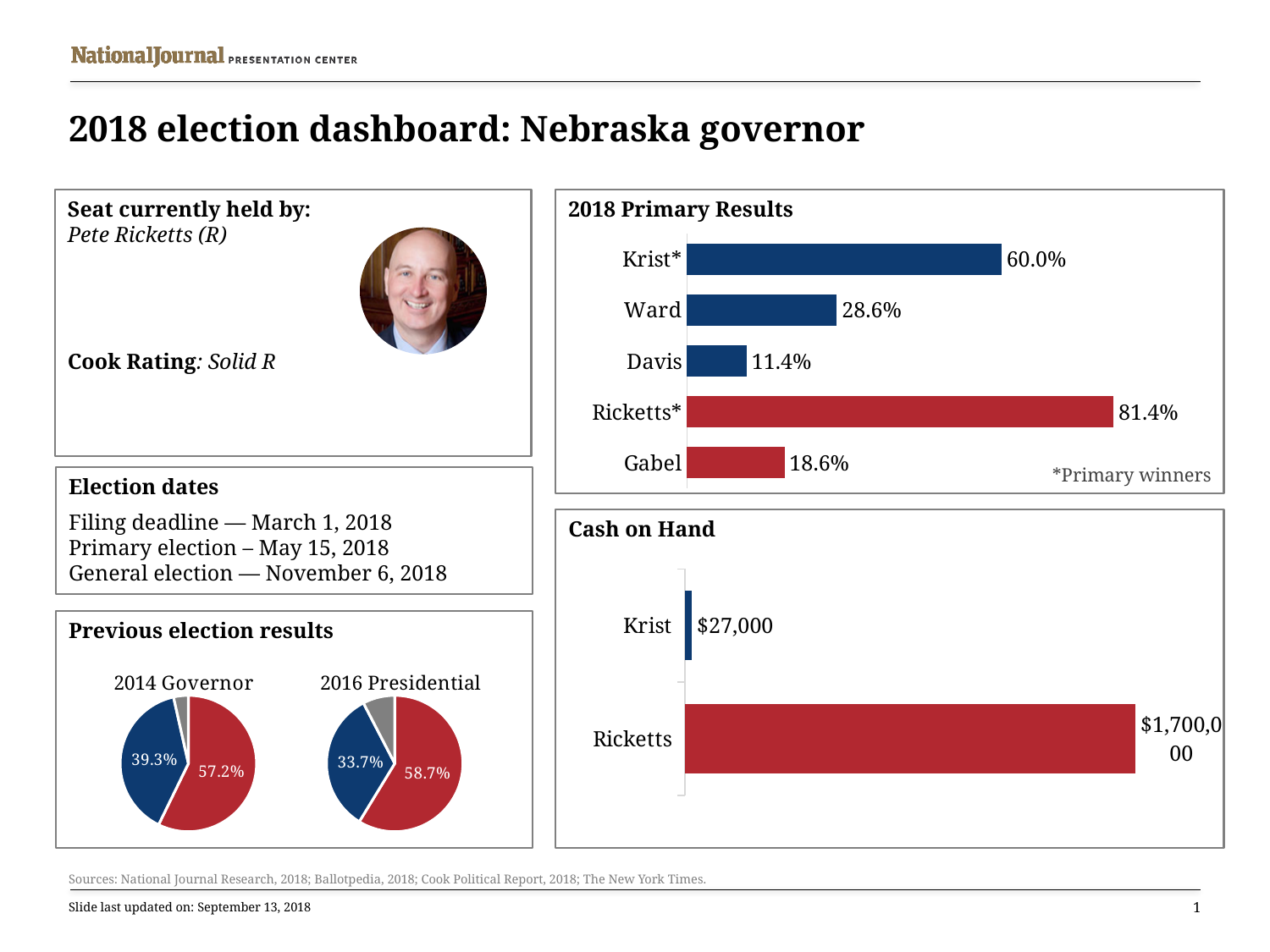
In the 2014 Governor pie chart, what is the value of the largest slice? 57.2% In the 2018 Primary Results chart, which candidate has the lowest percentage? Davis How many candidates are shown in the 2018 Primary Results chart? 5 In the 2018 Primary Results chart, which candidate has the highest percentage? Ricketts* In the 2018 Primary Results chart, who received a larger share, Ward or Gabel? Ward In the 2018 Primary Results chart, what percentage did Gabel receive? 18.6% In the Cash on Hand chart, how much cash on hand does Ricketts have? $1,700,000 In the 2018 Primary Results chart, what percentage did Krist* receive? 60.0% What kind of chart is the 2018 Primary Results chart? Bar chart In the 2016 Presidential pie chart, what is the value of the blue slice? 33.7% In the Cash on Hand chart, how much cash on hand does Krist have? $27,000 In the 2018 Primary Results chart, what is the difference between Ward's and Davis's percentages? 17.2%